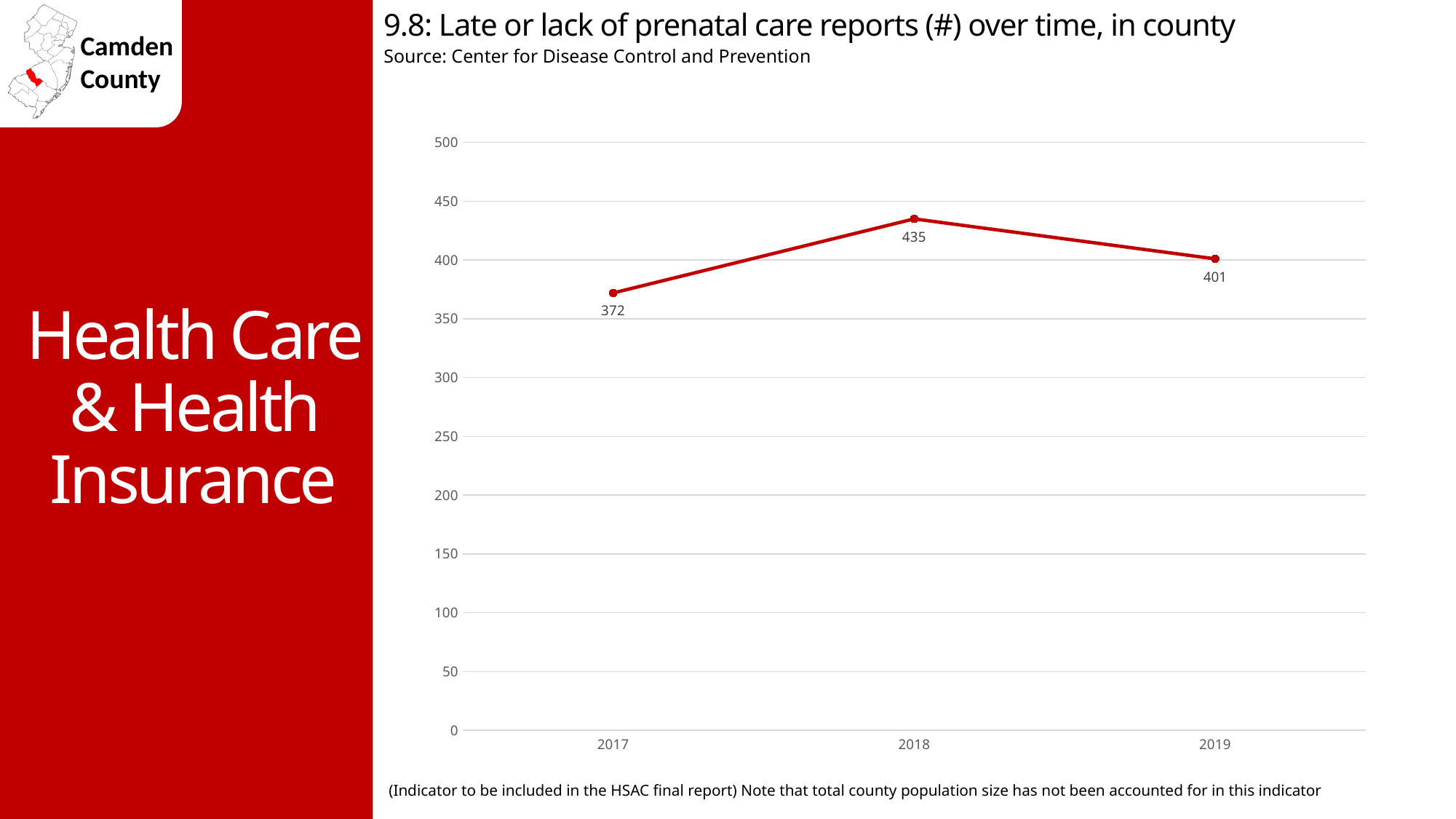
What is the number of late or lack of prenatal care reports in 2017? 372 What is the number of late or lack of prenatal care reports in 2019? 401 Which year has the highest number of late or lack of prenatal care reports? 2018 How many years are plotted on the chart? 3 What is the number of late or lack of prenatal care reports in 2018? 435 What is the difference between the number of reports in 2018 and 2019? 34 Which year has more late or lack of prenatal care reports, 2017 or 2019? 2019 Is the value for 2017 greater or less than 400? less Which year has the lowest number of late or lack of prenatal care reports? 2017 What is the difference between the number of reports in 2018 and 2017? 63 What is the source of the data shown in the chart? Center for Disease Control and Prevention What kind of chart is shown on the slide? line chart